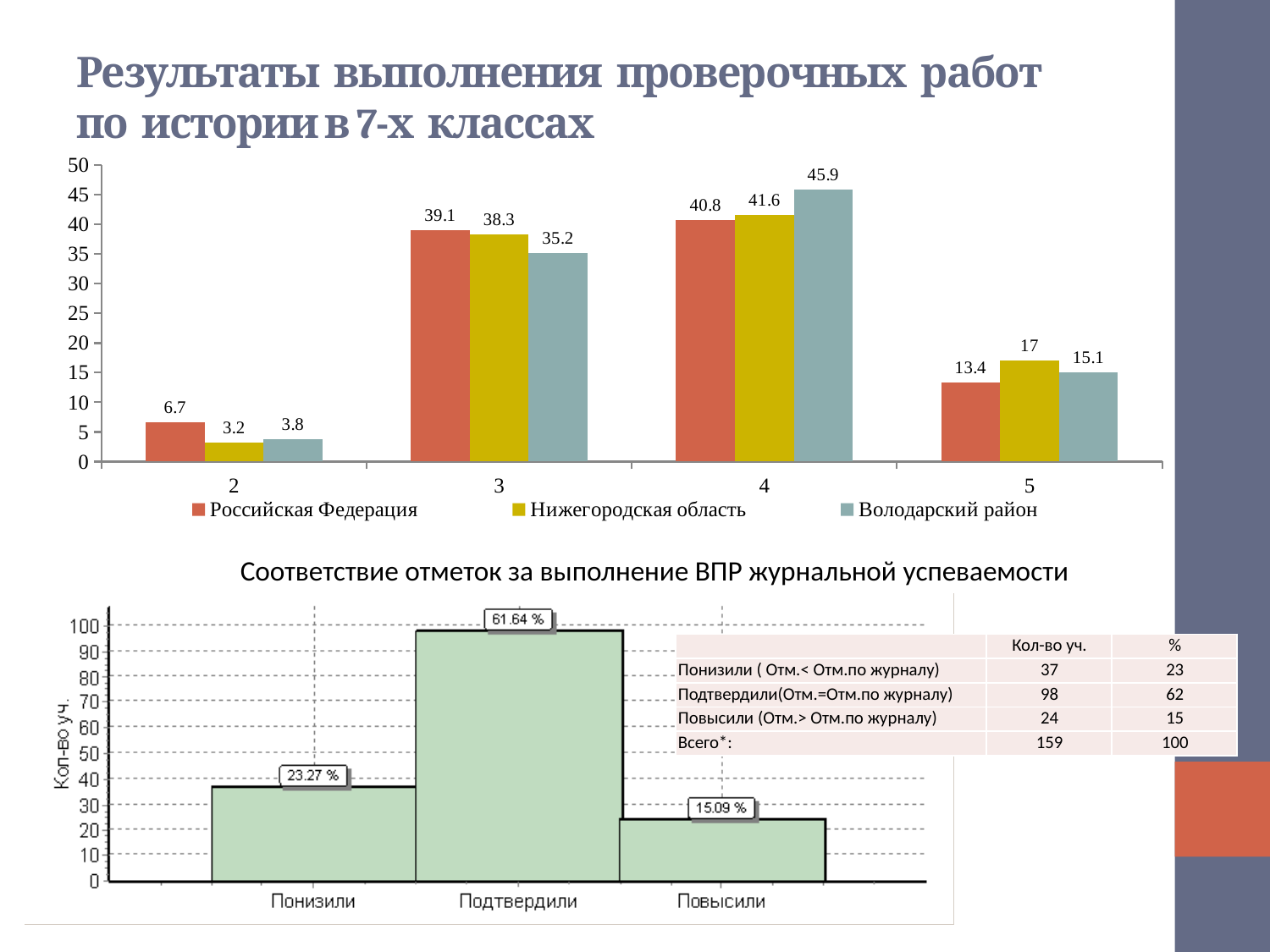
In the top chart, what is the value for Нижегородская область for category 5? 17 In the bottom chart 'Соответствие отметок за выполнение ВПР журнальной успеваемости', what percentage is labelled on the Подтвердили bar? 61.64 % In the top chart, what is the value for Володарский район for category 4? 45.9 What kind of chart is the bottom chart 'Соответствие отметок за выполнение ВПР журнальной успеваемости'? bar chart In the bottom chart 'Соответствие отметок за выполнение ВПР журнальной успеваемости', which category has the lowest bar? Повысили How many categories are shown on the x axis of the top chart? 4 In the top chart, which category has the lowest value for Нижегородская область? 2 How many series does the legend of the top chart list? 3 In the top chart, what is the value for Российская Федерация for category 2? 6.7 In the top chart, for category 5, which is larger: Российская Федерация or Володарский район? Володарский район In the top chart, what is the difference between Российская Федерация and Володарский район for category 3? 3.9 In the top chart, which category has the highest value for Володарский район? 4